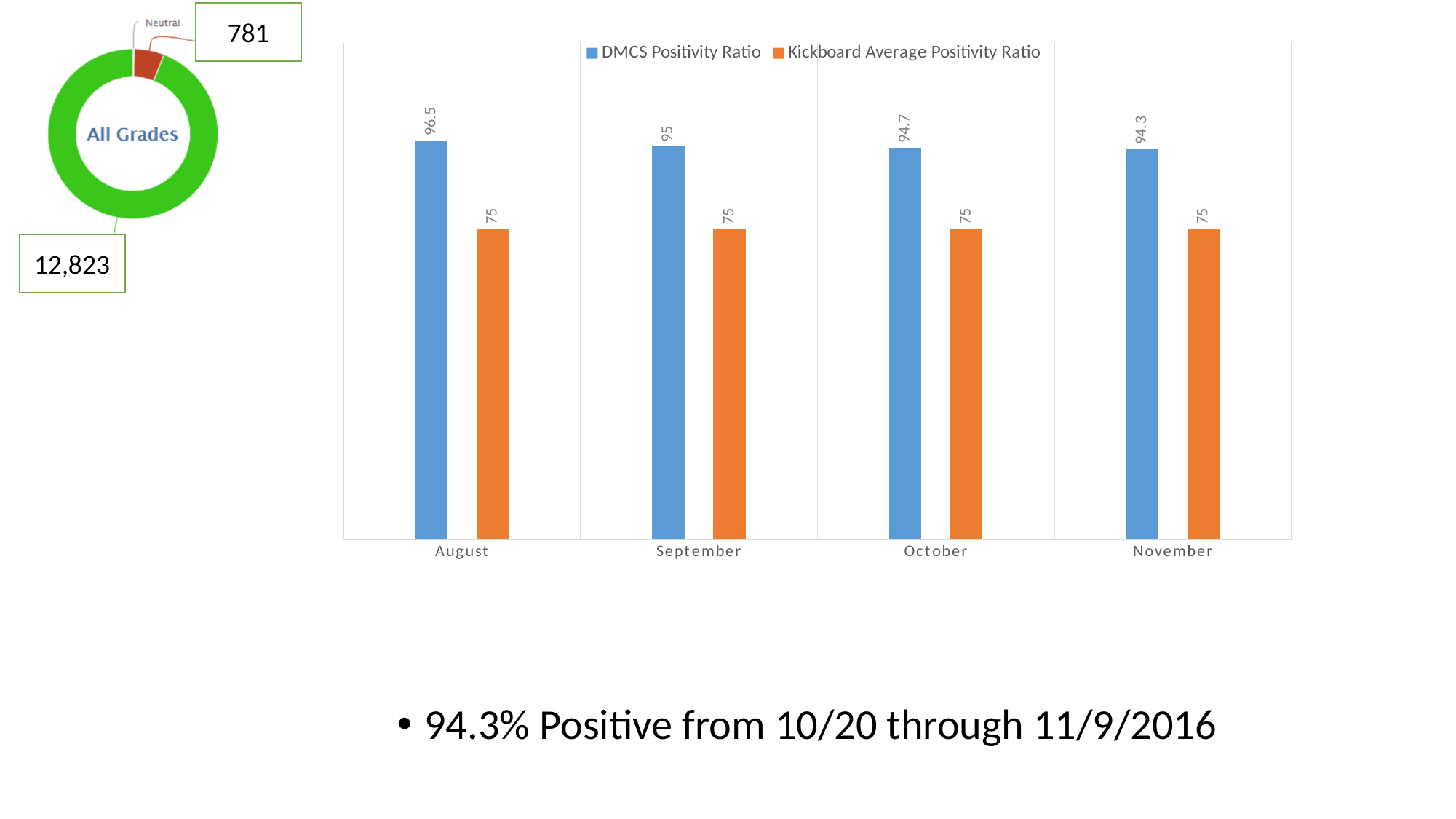
In the bar chart, what is the Kickboard Average Positivity Ratio for October? 75 How many months are shown on the x axis of the bar chart? 4 In the bar chart, which month has the lowest DMCS Positivity Ratio? November In the All Grades donut chart, what is the value of the green segment? 12,823 In the bar chart, which month has the highest DMCS Positivity Ratio? August In the bar chart, which is larger in October: the DMCS Positivity Ratio or the Kickboard Average Positivity Ratio? DMCS Positivity Ratio How many series does the legend of the bar chart list? 2 In the bar chart, what is the DMCS Positivity Ratio for November? 94.3 In the bar chart, what is the difference between the DMCS Positivity Ratio and the Kickboard Average Positivity Ratio in August? 21.5 In the All Grades donut chart, what is the value of the Neutral segment? 781 In the bar chart, does the DMCS Positivity Ratio rise or fall from August to November? fall In the bar chart, what is the DMCS Positivity Ratio for August? 96.5